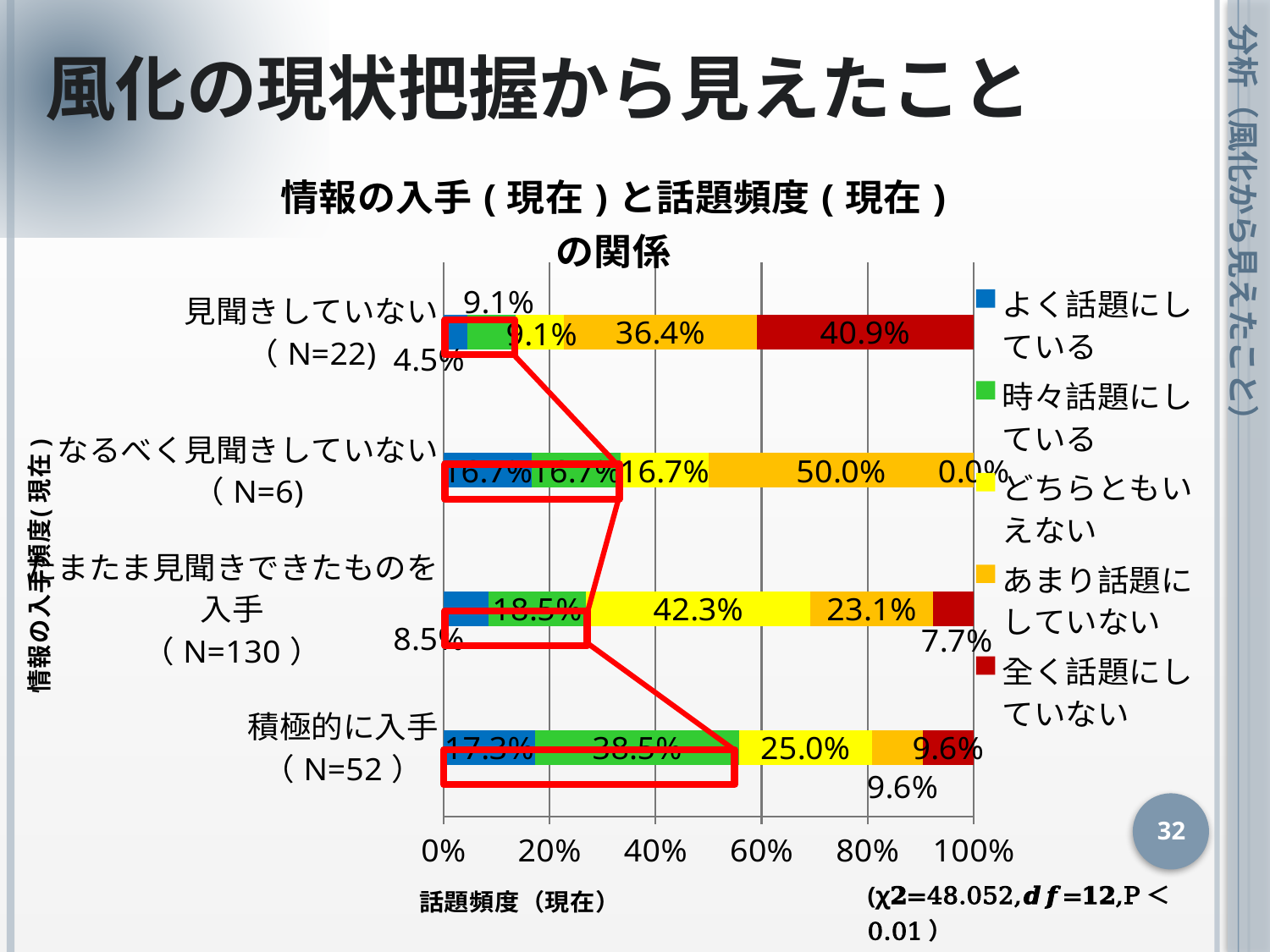
Which has the larger どちらともいえない share: たまたま見聞きできたものを入手 (N=130) or 積極的に入手 (N=52)? たまたま見聞きできたものを入手 (N=130) How many series does the legend list? 5 What percentage of the 積極的に入手 (N=52) group is 時々話題にしている? 38.5% What is the どちらともいえない share for たまたま見聞きできたものを入手 (N=130)? 42.3% What is the あまり話題にしていない value for the 見聞きしていない (N=22) group? 36.4% How much larger is the 時々話題にしている share for 積極的に入手 (N=52) than for 見聞きしていない (N=22)? 29.4 percentage points How many categories (bars) are shown on the y axis of the chart? 4 What percentage of the 見聞きしていない (N=22) group is 全く話題にしていない? 40.9% What is the value for あまり話題にしていない in the なるべく見聞きしていない (N=6) bar? 50.0% What kind of chart is shown on the slide? Stacked bar chart Which category has the lowest share of 全く話題にしていない? なるべく見聞きしていない (N=6) Which category has the highest share of 全く話題にしていない? 見聞きしていない (N=22)